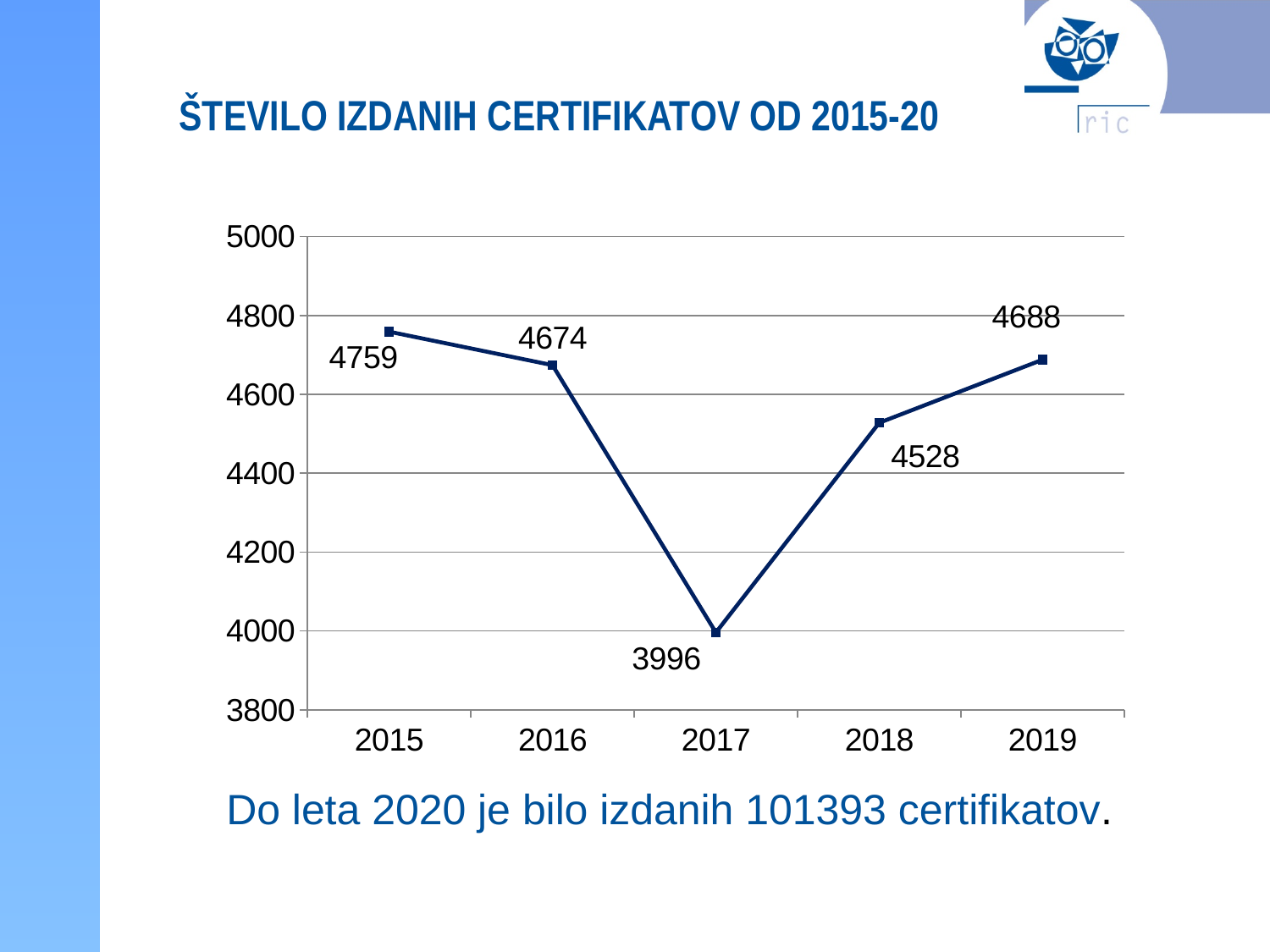
What is the difference between the values for 2019 and 2018? 160 How many years are plotted on the chart? 5 Is the value for 2017 greater or less than 4000? less What is the value for 2015? 4759 Which year has the lowest value? 2017 Which year has the highest value? 2015 Do the values rise or fall from 2017 to 2019? rise What is the value for 2017? 3996 What is the value for 2018? 4528 Which is larger, the value for 2016 or the value for 2019? 2019 What kind of chart is shown on the slide? line chart What is the difference between the values for 2015 and 2017? 763